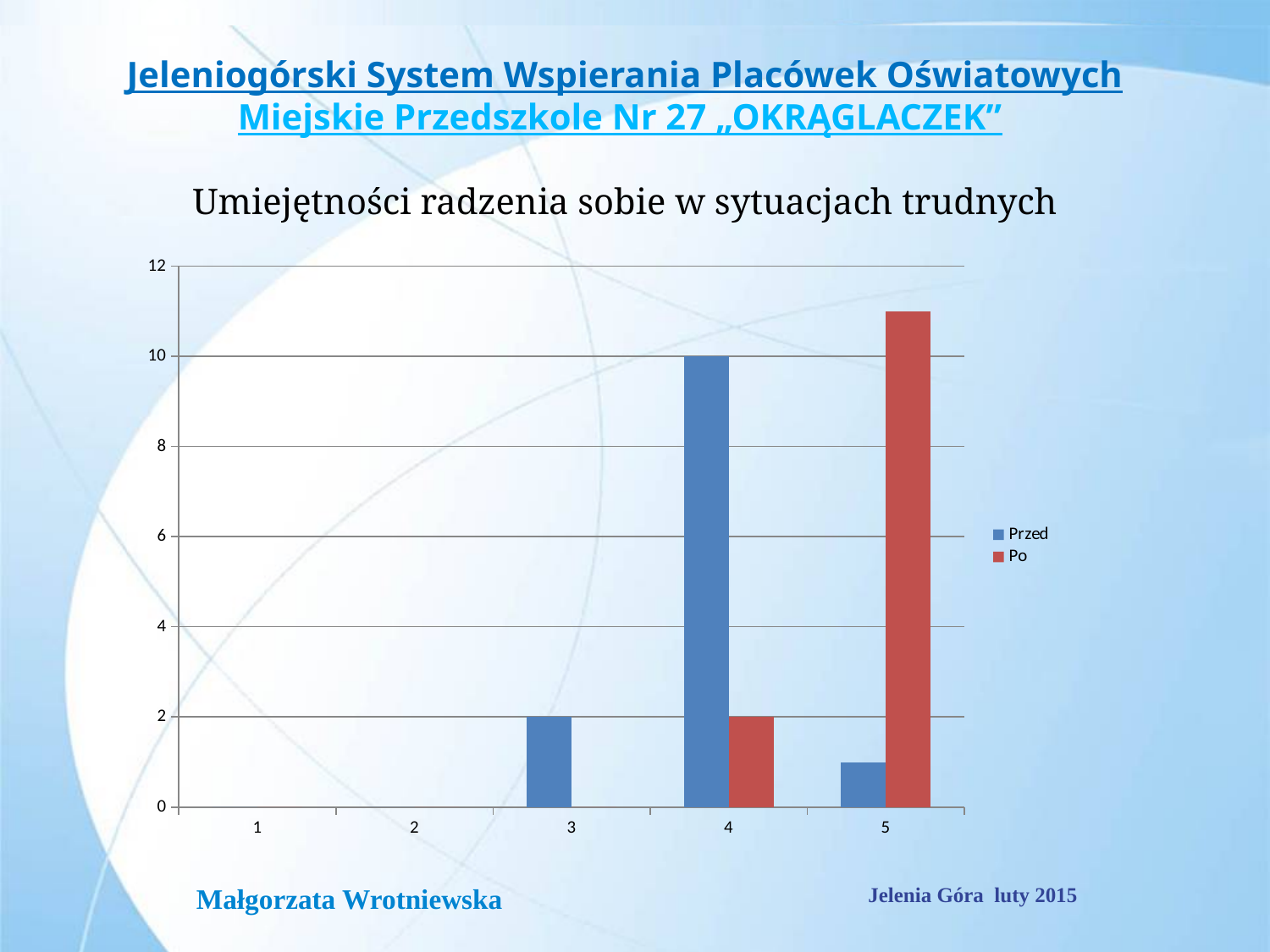
What is the difference between the Przed value for category 4 and the Przed value for category 3? 8 How many categories are shown on the x axis? 5 Is the value of the Przed series for category 5 greater or less than 2? less What is the value of the Po series for category 4? 2 What is the value of the Przed series for category 3? 2 For which category is the Przed series highest? 4 Is the value of the Po series for category 5 greater or less than 10? greater For category 4, which series has the larger value, Przed or Po? Przed What type of chart is shown on the slide? bar chart For which category is the Po series highest? 5 How many series does the legend list? 2 What is the value of the Przed series for category 4? 10